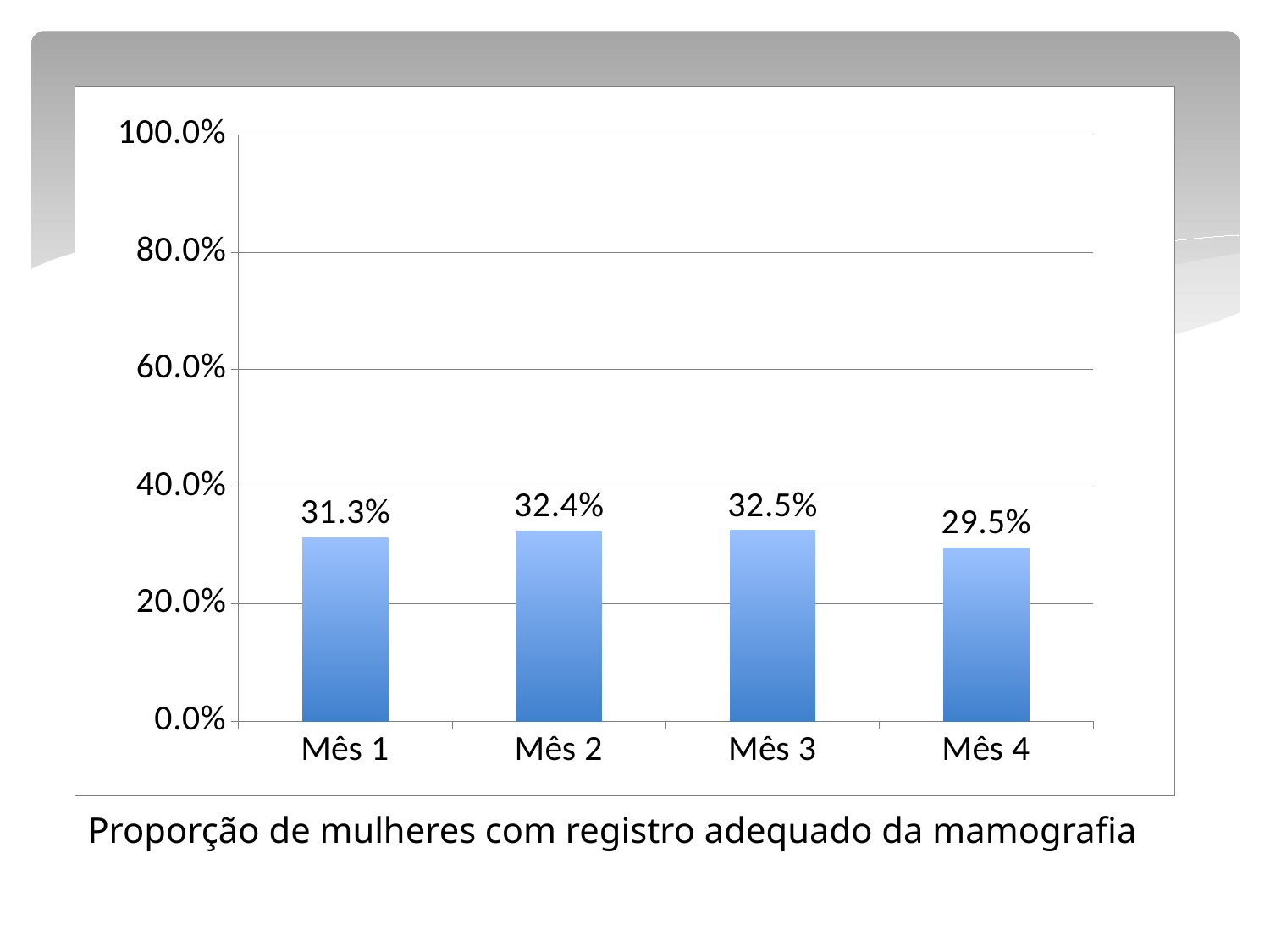
What kind of chart is shown on the slide? bar chart What is the value for Mês 2? 32.4% Which month has the highest value? Mês 3 What is the value for Mês 1? 31.3% How many months are shown on the x axis? 4 Is the value for Mês 2 greater or less than 40.0%? less Which month has the lowest value? Mês 4 What is the value for Mês 4? 29.5% What is the value for Mês 3? 32.5% Which is larger, the value for Mês 1 or the value for Mês 4? Mês 1 What is the caption printed below the chart? Proporção de mulheres com registro adequado da mamografia What is the difference between the values for Mês 3 and Mês 4? 3.0%